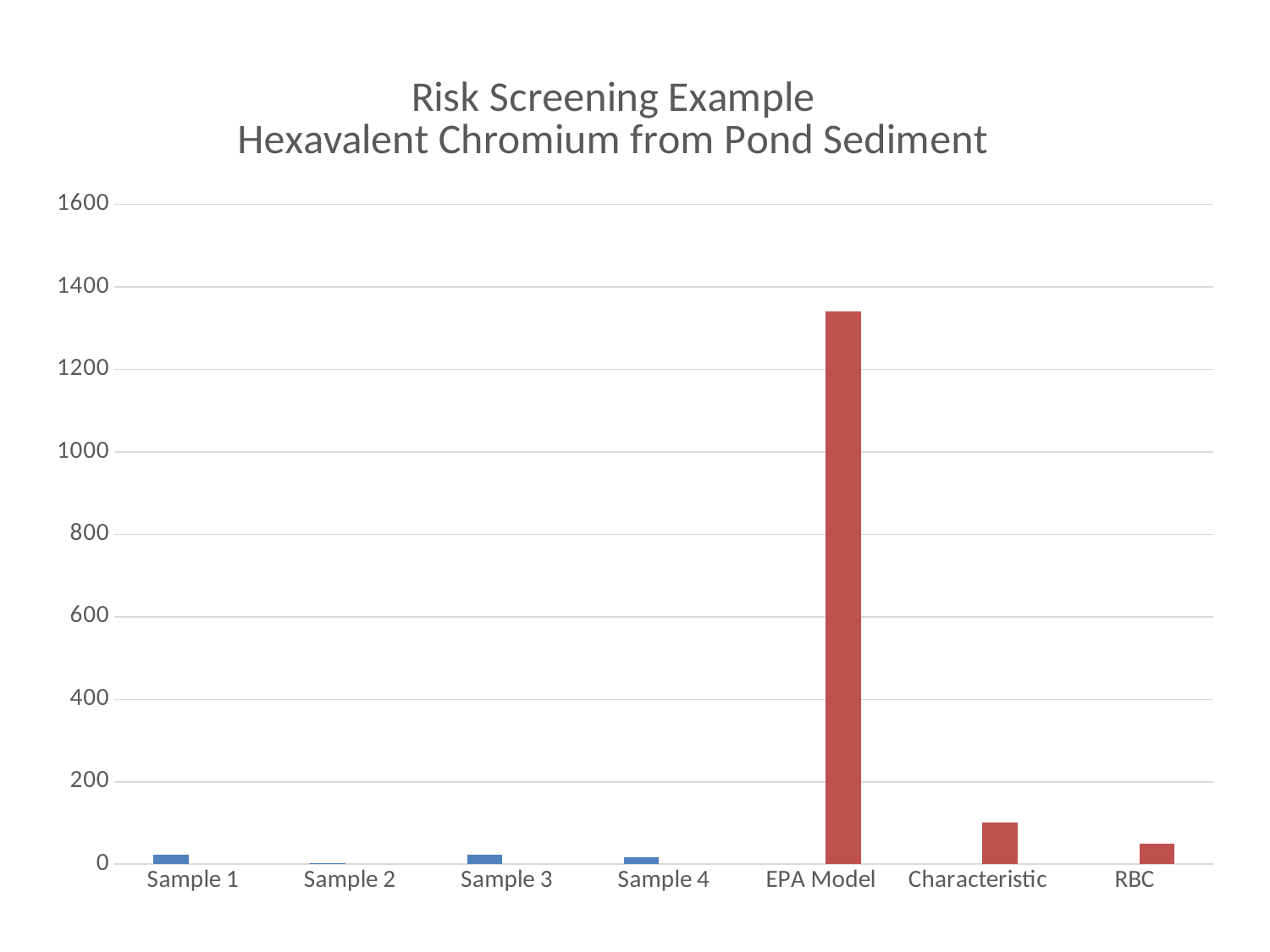
How many categories are shown on the x axis of the chart? 7 Is the value for Characteristic greater or less than 200? less Which category has the highest value in the chart? EPA Model What colour are the bars for Sample 1 through Sample 4? Blue Is the value for EPA Model greater or less than 1200? greater Which is larger, the value for Characteristic or the value for RBC? Characteristic Which category has the lowest value in the chart? Sample 2 Is the value for Sample 1 greater or less than 200? less Which is larger, the value for EPA Model or the value for Characteristic? EPA Model What kind of chart is shown on the slide? Bar chart What is the title of the chart? Risk Screening Example Hexavalent Chromium from Pond Sediment